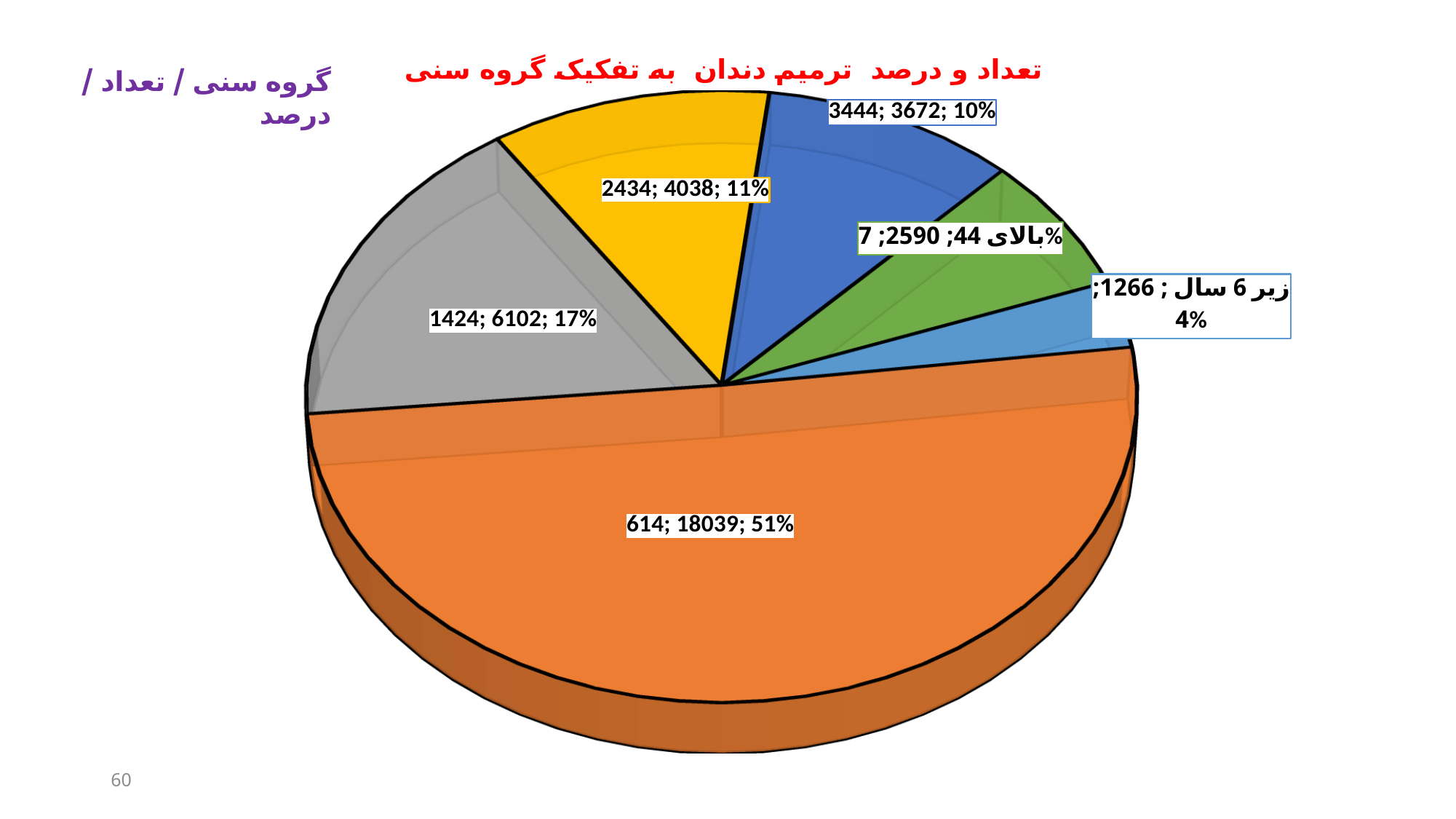
Which slice of the pie chart is the largest? 614 (18039; 51%) Which has the larger count: the slice labelled '3444' or the slice labelled '2434'? 2434 (4038) What is the count shown for the slice labelled 'زیر 6 سال'? 1266 What share of the pie does the slice labelled 'بالای 44' represent? 7% What colour is the largest slice of the pie chart? orange What share of the pie does the slice labelled '1424' represent? 17% What is the total of all the counts shown on the pie chart? 35707 What kind of chart is shown on the slide? pie chart What is the count shown for the slice labelled '1424'? 6102 What is the difference between the count for the slice labelled '614' and the count for the slice labelled '1424'? 11937 Which slice of the pie chart is the smallest? زیر 6 سال (1266; 4%) How many slices does the pie chart have? 6